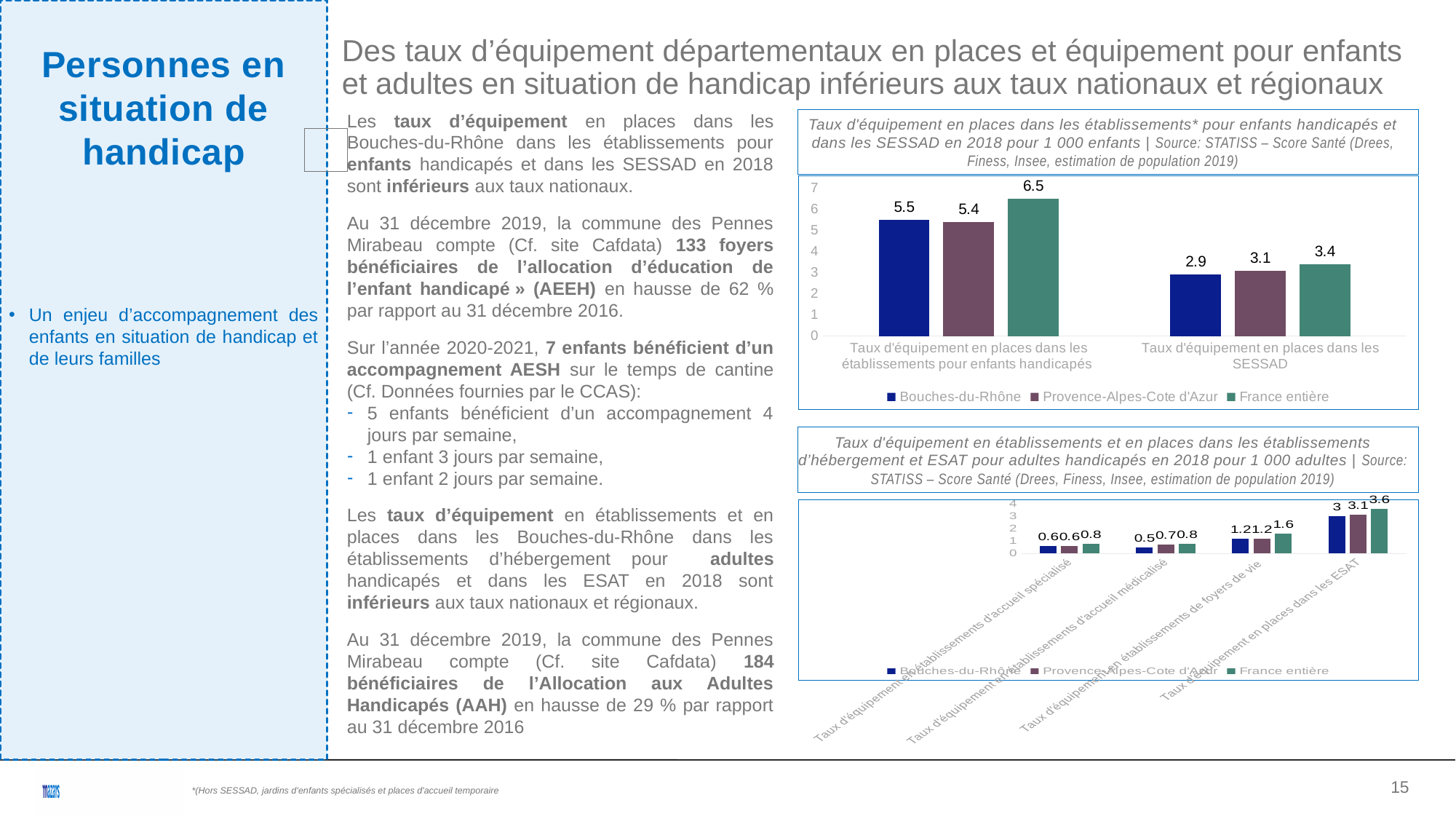
In the top chart, which series has the lowest value in the category 'Taux d'équipement en places dans les SESSAD'? Bouches-du-Rhône In the top chart (Taux d'équipement en places dans les établissements pour enfants handicapés et dans les SESSAD en 2018), what is the value for Bouches-du-Rhône in the category 'Taux d'équipement en places dans les établissements pour enfants handicapés'? 5.5 In the top chart, what is the difference between the France entière value and the Bouches-du-Rhône value in the category 'Taux d'équipement en places dans les établissements pour enfants handicapés'? 1 In the top chart, which series has the highest value in the category 'Taux d'équipement en places dans les établissements pour enfants handicapés'? France entière In the top chart, how many series does the legend list? 3 In the top chart, what is the value for Provence-Alpes-Cote d'Azur in the category 'Taux d'équipement en places dans les SESSAD'? 3.1 What kind of chart is the top chart on the slide? Bar chart In the bottom chart, how many categories are shown on the x axis? 4 In the bottom chart, which category has the highest values for all three series? Taux d'équipement en places dans les ESAT In the bottom chart, what is the value for Bouches-du-Rhône in the category 'Taux d'équipement en places dans les ESAT'? 3 In the top chart, what is the value for France entière in the category 'Taux d'équipement en places dans les SESSAD'? 3.4 In the bottom chart (taux d'équipement pour adultes handicapés en 2018), what is the value for France entière in the category 'Taux d'équipement en places dans les ESAT'? 3.6